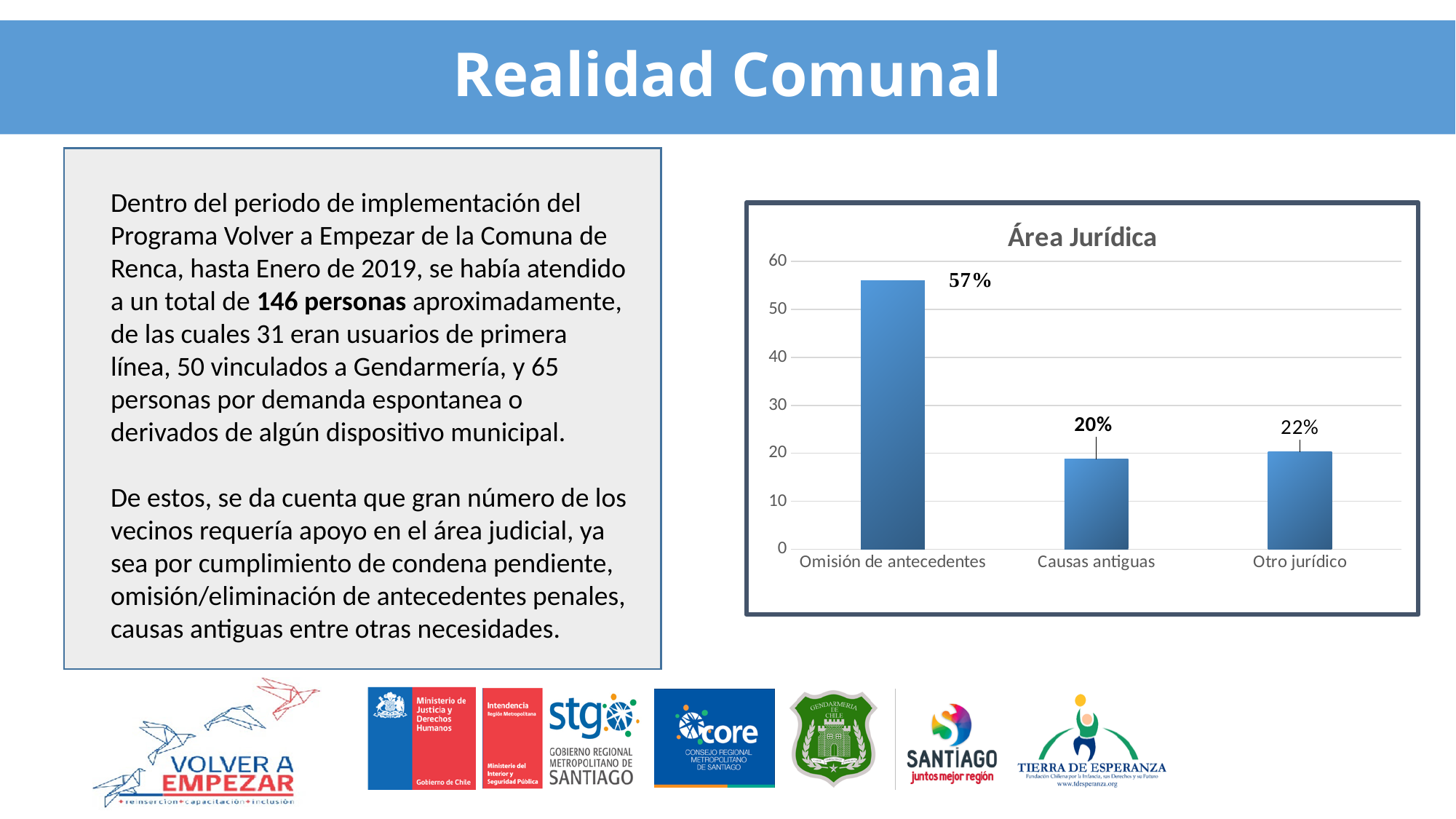
Which has the larger labelled value, Causas antiguas or Otro jurídico? Otro jurídico Is the bar for Omisión de antecedentes greater or less than 50 on the y axis? greater How many categories are shown in the Área Jurídica chart? 3 What is the data label shown for Otro jurídico in the Área Jurídica chart? 22% What is the data label shown for Omisión de antecedentes in the Área Jurídica chart? 57% Which category has the lowest value in the Área Jurídica chart? Causas antiguas What is the title of the chart on the slide? Área Jurídica What type of chart is shown on the slide? Bar chart Which category has the highest value in the Área Jurídica chart? Omisión de antecedentes What is the data label shown for Causas antiguas in the Área Jurídica chart? 20% By how many percentage points does the label for Omisión de antecedentes exceed the label for Causas antiguas? 37 Is the bar for Causas antiguas greater or less than 30 on the y axis? less